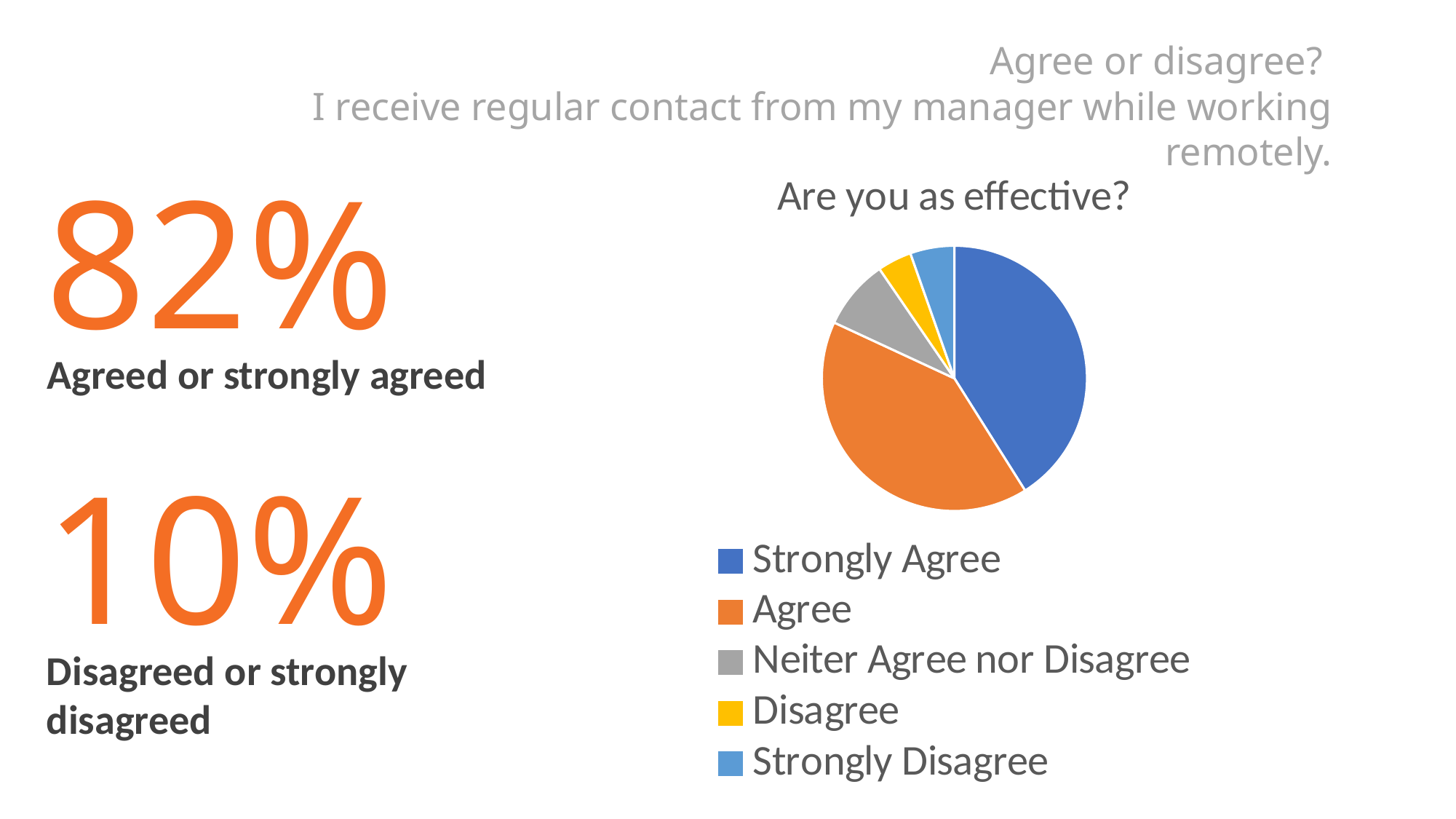
Which colour represents Agree in the pie chart? orange Which slice is larger in the pie chart, Strongly Agree or Neiter Agree nor Disagree? Strongly Agree How many slices does the pie chart have? 5 Which slice is larger in the pie chart, Agree or Strongly Disagree? Agree How many entries does the legend of the pie chart list? 5 Which legend entry is shown in yellow in the pie chart? Disagree Which slice is larger in the pie chart, Neiter Agree nor Disagree or Disagree? Neiter Agree nor Disagree What kind of chart is shown on the slide? pie chart What is the title of the pie chart? Are you as effective?